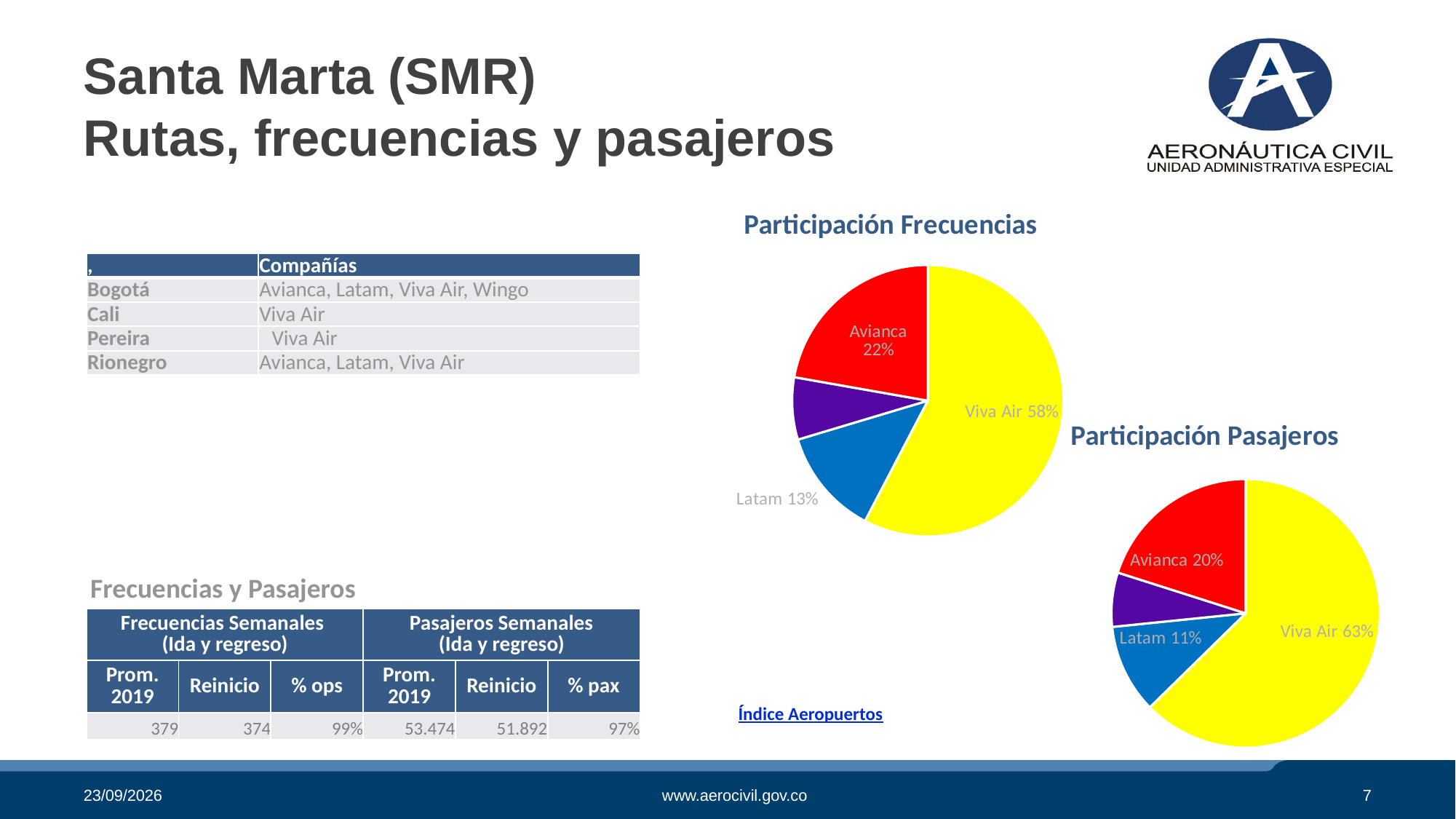
In the 'Participación Pasajeros' chart, which airline has the largest slice? Viva Air In the 'Participación Pasajeros' chart, which is larger, Avianca's share or Latam's share? Avianca In the 'Participación Pasajeros' chart, what share does Avianca have? 20% In the 'Participación Pasajeros' chart, what share does Latam have? 11% What type of chart is 'Participación Pasajeros'? Pie chart In the 'Participación Pasajeros' chart, what share does Viva Air have? 63% In the 'Participación Frecuencias' chart, what is the difference in percentage points between Viva Air and Avianca? 36 percentage points In the 'Participación Frecuencias' chart, which airline has the largest slice? Viva Air How many slices does the 'Participación Frecuencias' pie chart have? 4